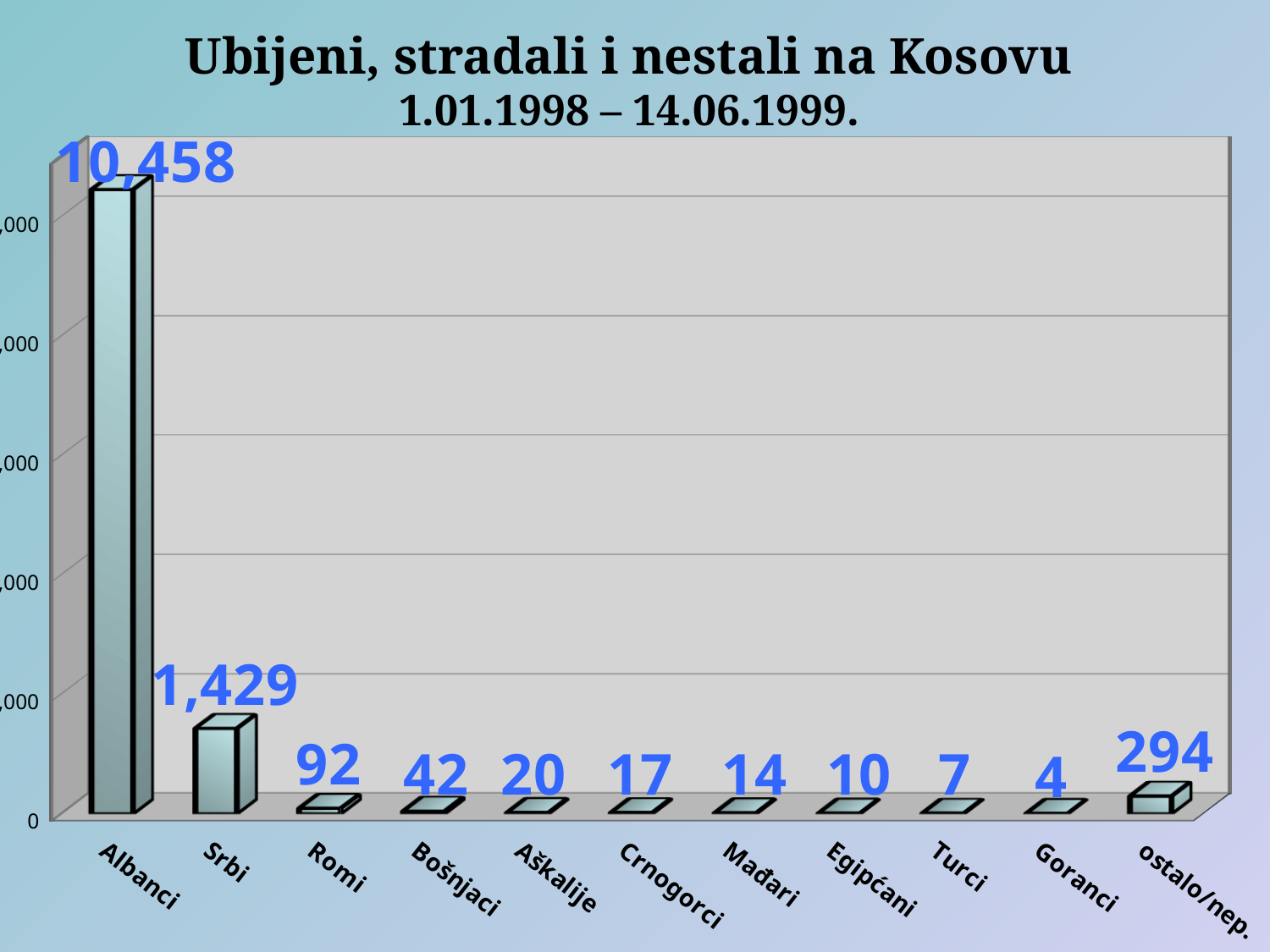
What is the value for Goranci? 4 Which category has the highest value? Albanci What is the value for Albanci? 10,458 What is the value for ostalo/nep.? 294 How many categories are shown on the x axis? 11 What is the title of the chart? Ubijeni, stradali i nestali na Kosovu 1.01.1998 – 14.06.1999. Which is larger, the value for Bošnjaci or the value for Aškalije? Bošnjaci What is the value for Romi? 92 What is the difference between the values for Albanci and Srbi? 9,029 What kind of chart is shown on the slide? Bar chart What is the value for Srbi? 1,429 Which category has the lowest value? Goranci